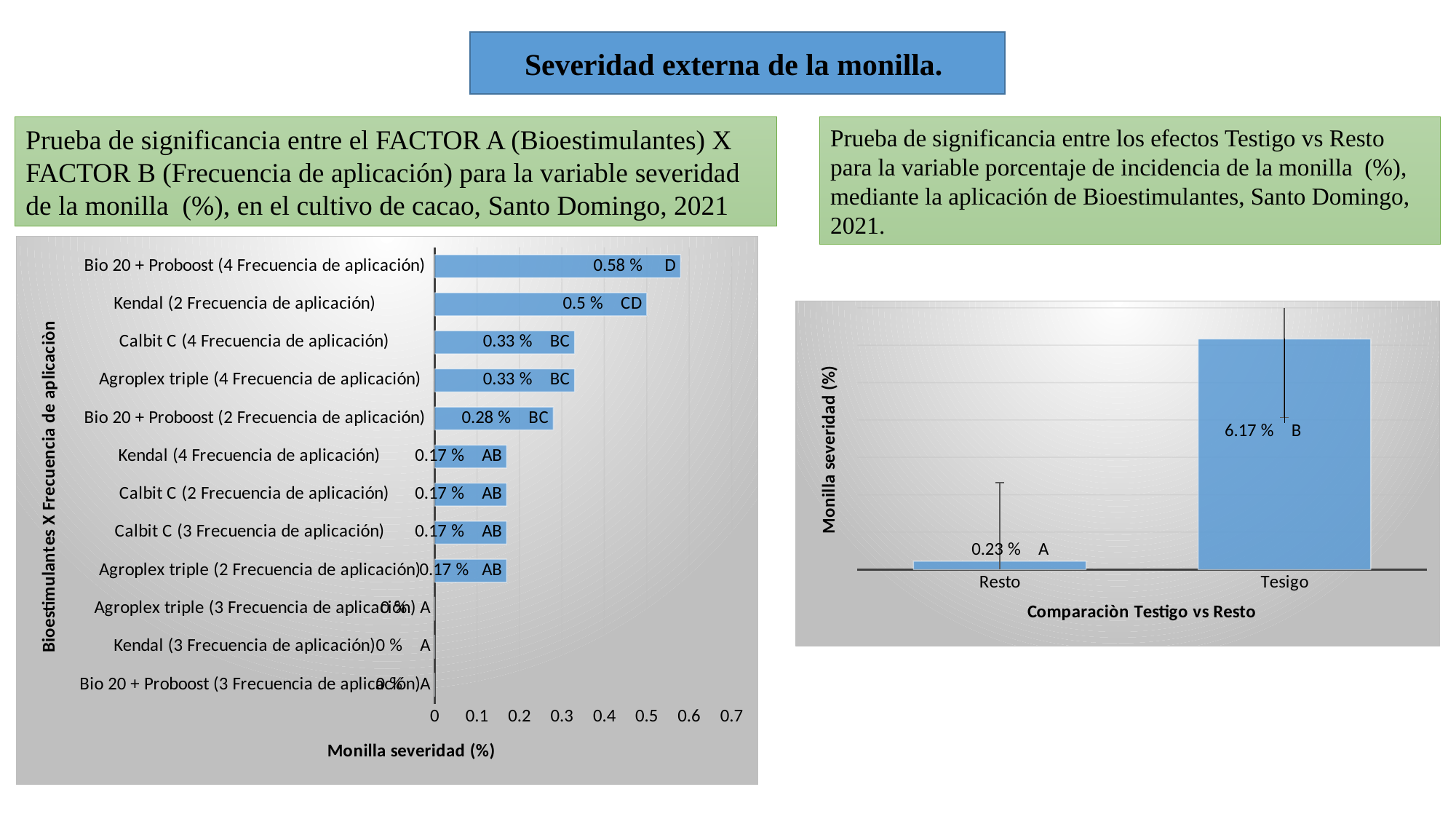
In the left chart, what is the value for Bio 20 + Proboost (2 Frecuencia de aplicación)? 0.28 % In the left chart, which category has the highest Monilla severidad value? Bio 20 + Proboost (4 Frecuencia de aplicación) How many categories are plotted in the left chart? 12 In the right chart, what is the value for Resto? 0.23 % In the left chart, what is the difference between the values for Bio 20 + Proboost (4 Frecuencia de aplicación) and Kendal (2 Frecuencia de aplicación)? 0.08 % In the left chart, what is the Monilla severidad value for Bio 20 + Proboost (4 Frecuencia de aplicación)? 0.58 % In the right chart, what is the Monilla severidad value for Tesigo? 6.17 % What kind of chart is the left chart? Bar chart In the left chart, what is the value for Kendal (2 Frecuencia de aplicación)? 0.5 % In the right chart, what is the difference between the values for Tesigo and Resto? 5.94 % In the left chart, which is larger: the value for Calbit C (4 Frecuencia de aplicación) or the value for Kendal (4 Frecuencia de aplicación)? Calbit C (4 Frecuencia de aplicación) What is the x-axis title of the right chart? Comparaciòn Testigo vs Resto